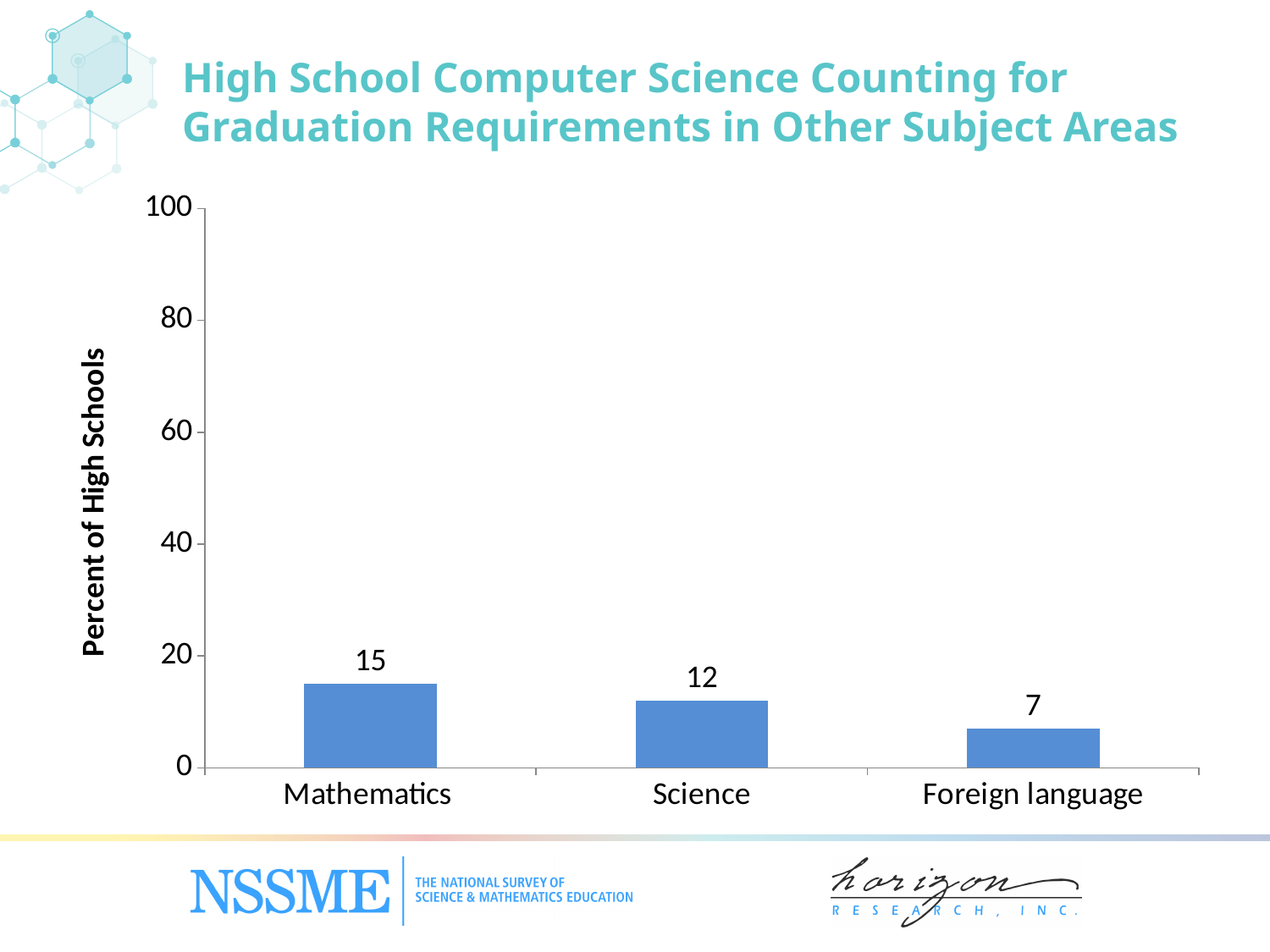
What is the difference between the values for Science and Foreign language? 5 How many subject areas are shown on the chart? 3 Which is larger, the value for Mathematics or the value for Science? Mathematics What is the value shown for Foreign language? 7 What is the difference between the values for Mathematics and Foreign language? 8 Is the value for Mathematics greater or less than 20? less What kind of chart is shown on the slide? Bar chart Which subject area has the highest percent of high schools? Mathematics Which subject area has the lowest percent of high schools? Foreign language What is the value shown for Science? 12 What is the label of the vertical axis? Percent of High Schools What percent of high schools allow computer science to count for the Mathematics graduation requirement? 15